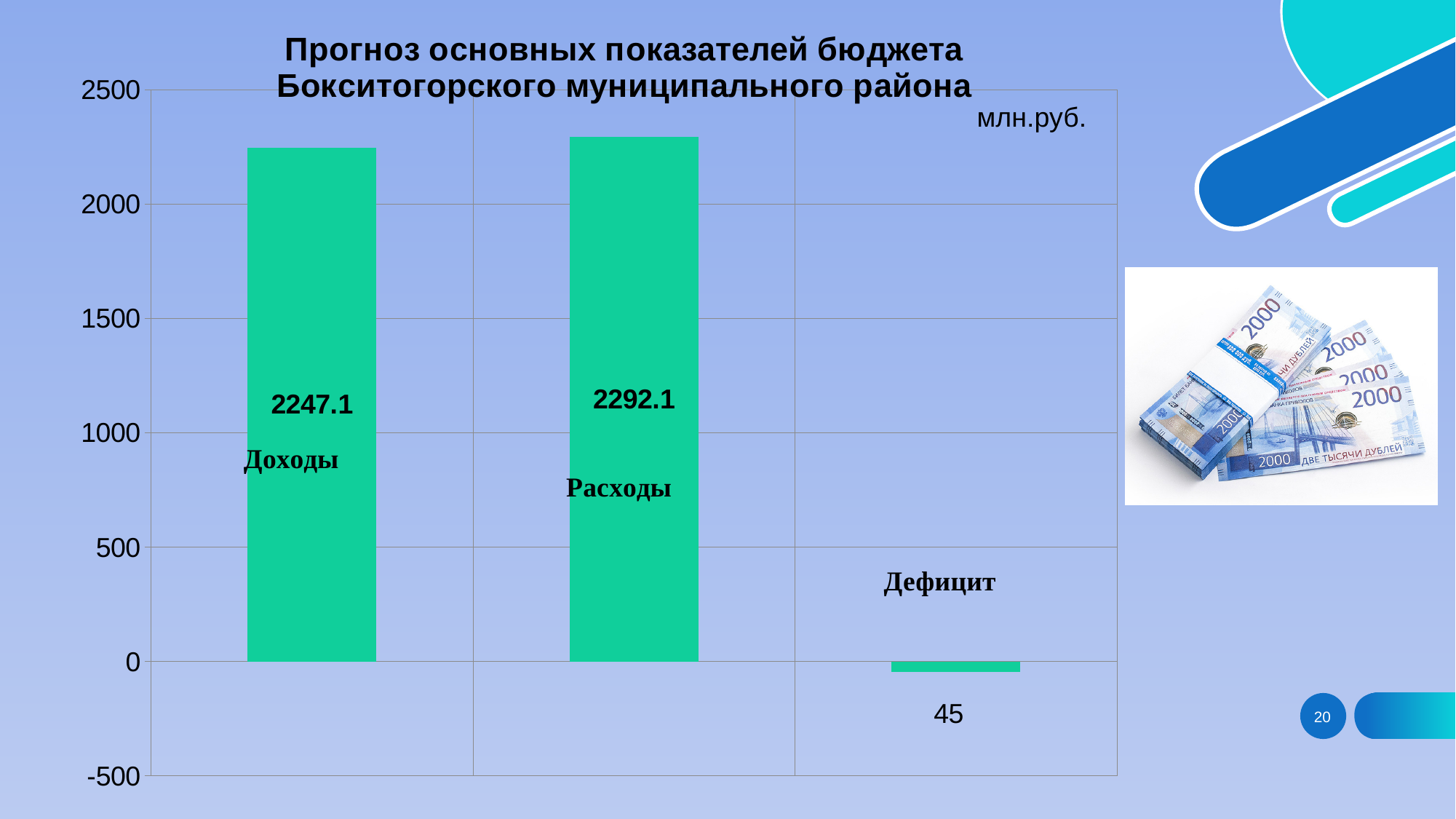
What kind of chart is shown on the slide? bar chart Which category has the lowest value? Дефицит What is the difference between Расходы and Доходы? 45 What unit is indicated for the chart values? млн.руб. Is the value for Доходы greater or less than 2000? greater What is the value for Доходы? 2247.1 Which category has the highest value? Расходы What is the title of the chart? Прогноз основных показателей бюджета Бокситогорского муниципального района What value is labelled for Дефицит? 45 How many categories are shown in the chart? 3 Which is larger, Доходы or Расходы? Расходы What is the value for Расходы? 2292.1